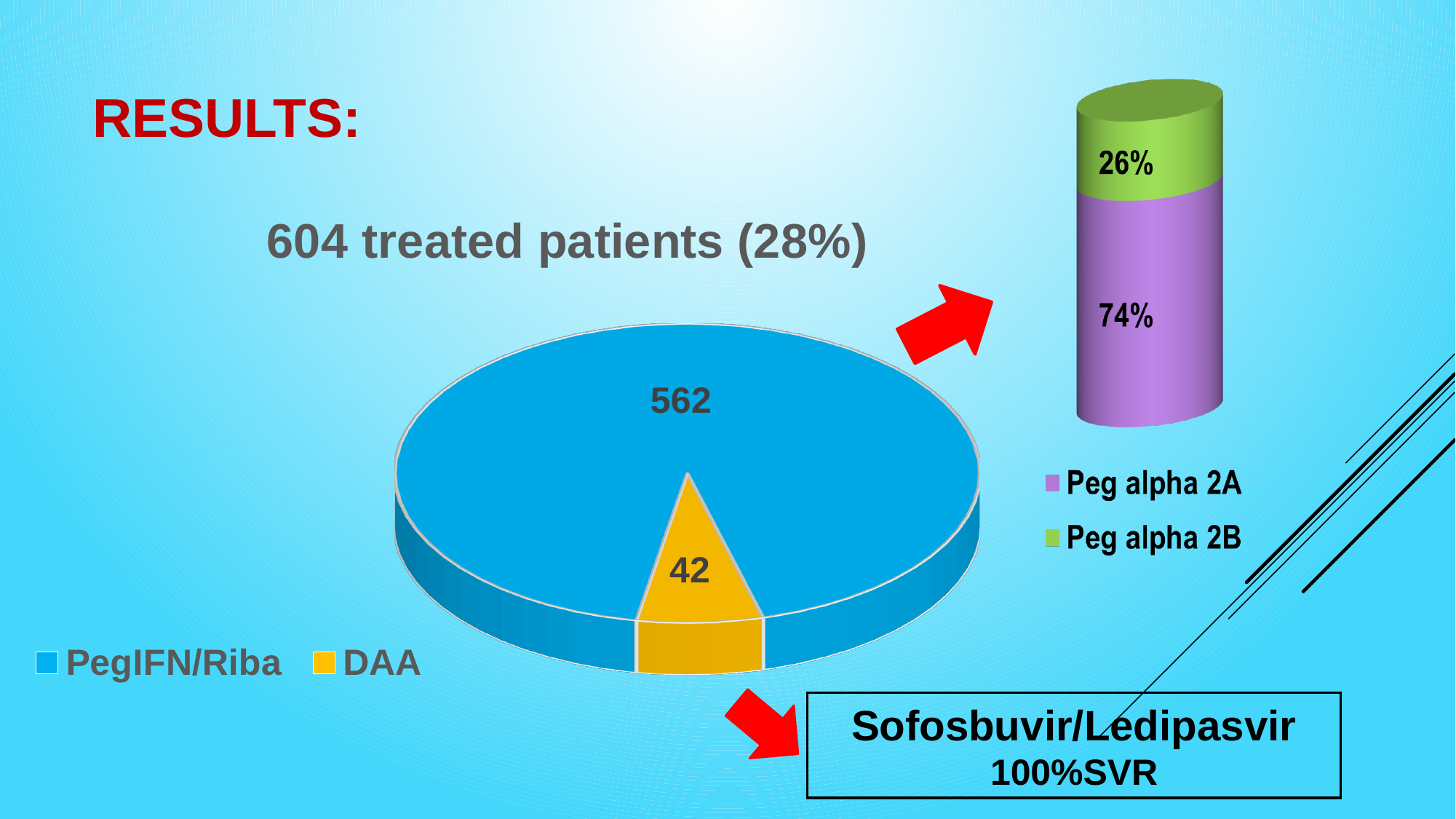
How many series does the legend of the stacked bar chart on the right list? 2 In the pie chart, which category has the smallest slice? DAA What kind of chart is the chart in the centre of the slide? Pie chart In the pie chart, what is the value for PegIFN/Riba? 562 In the stacked bar chart on the right, what is the value for Peg alpha 2A? 74% In the stacked bar chart on the right, which is larger, Peg alpha 2A or Peg alpha 2B? Peg alpha 2A How many slices does the pie chart have? 2 In the pie chart, what is the difference between the PegIFN/Riba value and the DAA value? 520 In the pie chart, which category has the largest slice? PegIFN/Riba In the pie chart, what is the total of the two slices? 604 In the stacked bar chart on the right, what is the value for Peg alpha 2B? 26% In the pie chart, what is the value for DAA? 42